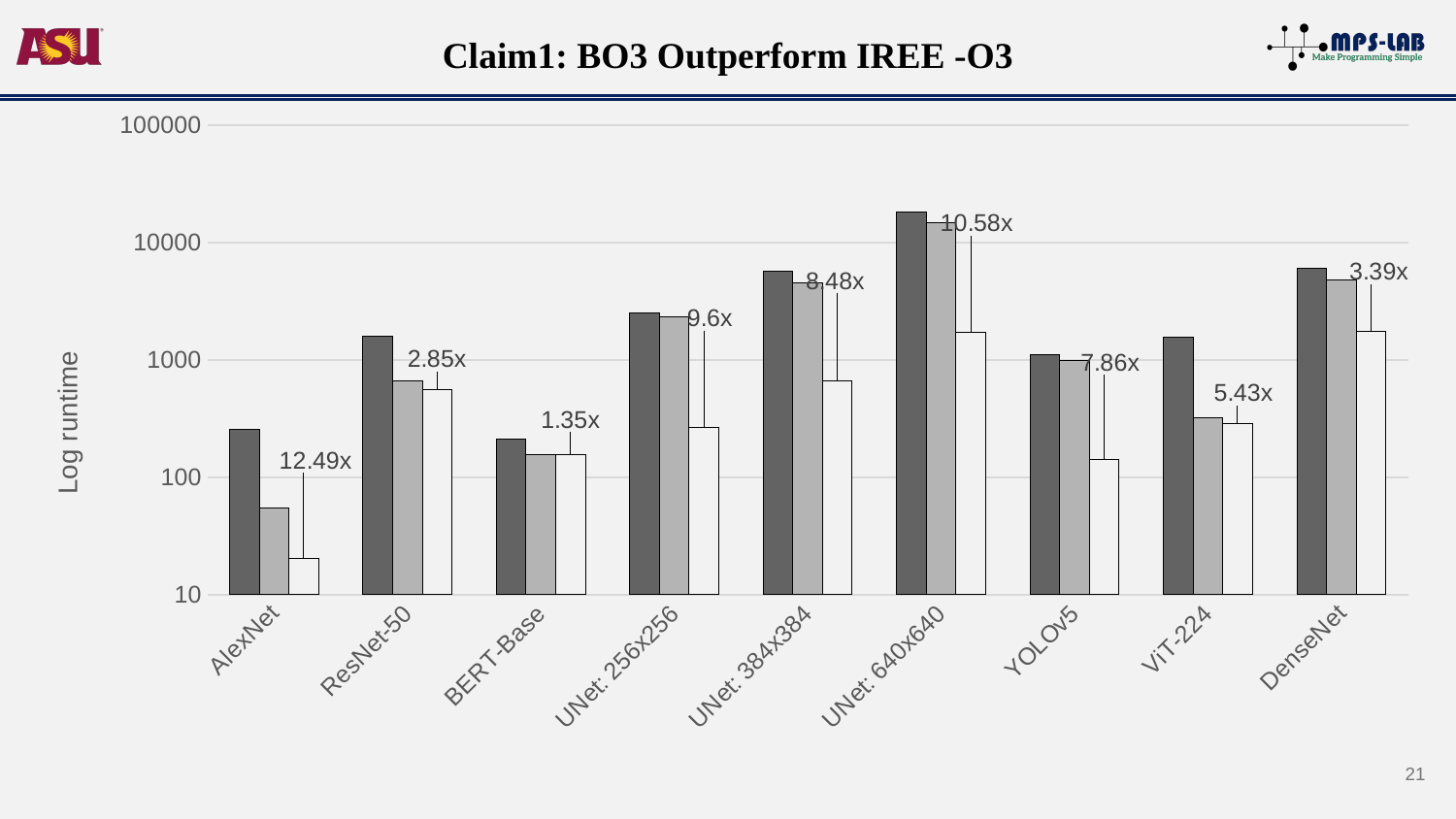
Is the dark gray bar for UNet: 640x640 greater or less than 10000? greater Which model has the lowest annotated speedup factor? BERT-Base How many bars are plotted for each model category? 3 What is the label of the y axis? Log runtime What speedup factor is annotated above the UNet: 640x640 bars? 10.58x How many model categories are shown along the x axis? 9 What speedup factor is annotated above the BERT-Base bars? 1.35x What speedup factor is annotated above the AlexNet bars? 12.49x Which model has the highest annotated speedup factor? AlexNet What kind of chart is shown on the slide? bar chart Is the white bar for AlexNet greater or less than 100? less Which model has the tallest dark gray bar? UNet: 640x640